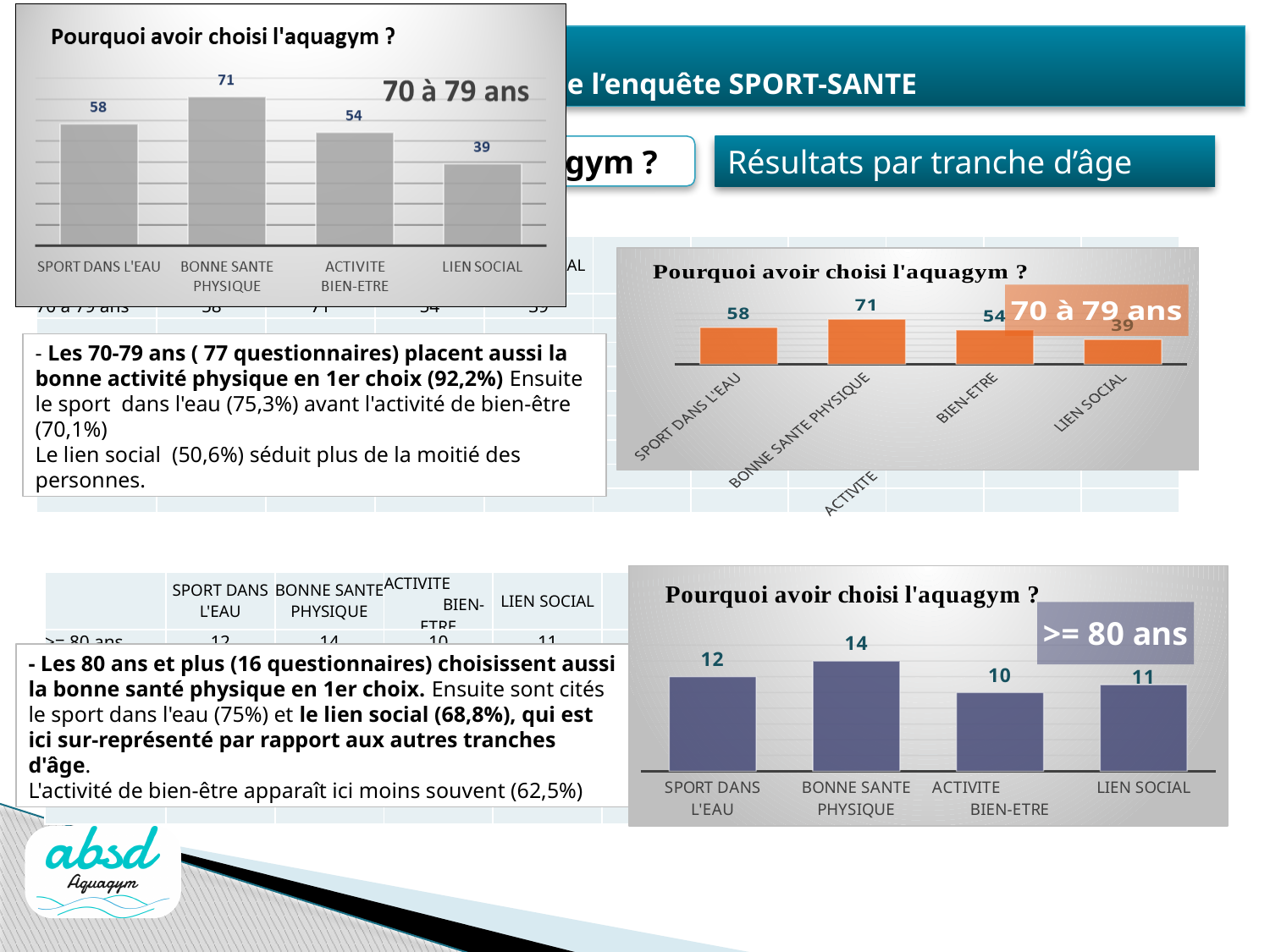
In the bottom-right chart labelled ">= 80 ans", which category has the lowest value? ACTIVITE BIEN-ETRE What is the title of the orange chart on the right? Pourquoi avoir choisi l'aquagym ? In the bottom-right chart labelled ">= 80 ans", how many categories are shown? 4 In the top-left grey chart labelled "70 à 79 ans", what is the value for SPORT DANS L'EAU? 58 In the bottom-right chart labelled ">= 80 ans", what is the value for BONNE SANTE PHYSIQUE? 14 What type of chart is the bottom-right chart labelled ">= 80 ans"? Bar chart In the bottom-right chart labelled ">= 80 ans", what is the value for LIEN SOCIAL? 11 In the top-left grey chart labelled "70 à 79 ans", what is the difference between BONNE SANTE PHYSIQUE and LIEN SOCIAL? 32 In the bottom-right chart labelled ">= 80 ans", what is the difference between BONNE SANTE PHYSIQUE and SPORT DANS L'EAU? 2 In the orange chart on the right labelled "70 à 79 ans", which is larger, SPORT DANS L'EAU or ACTIVITE BIEN-ETRE? SPORT DANS L'EAU In the top-left grey chart labelled "70 à 79 ans", which category has the highest value? BONNE SANTE PHYSIQUE In the orange chart on the right labelled "70 à 79 ans", what is the value for LIEN SOCIAL? 39